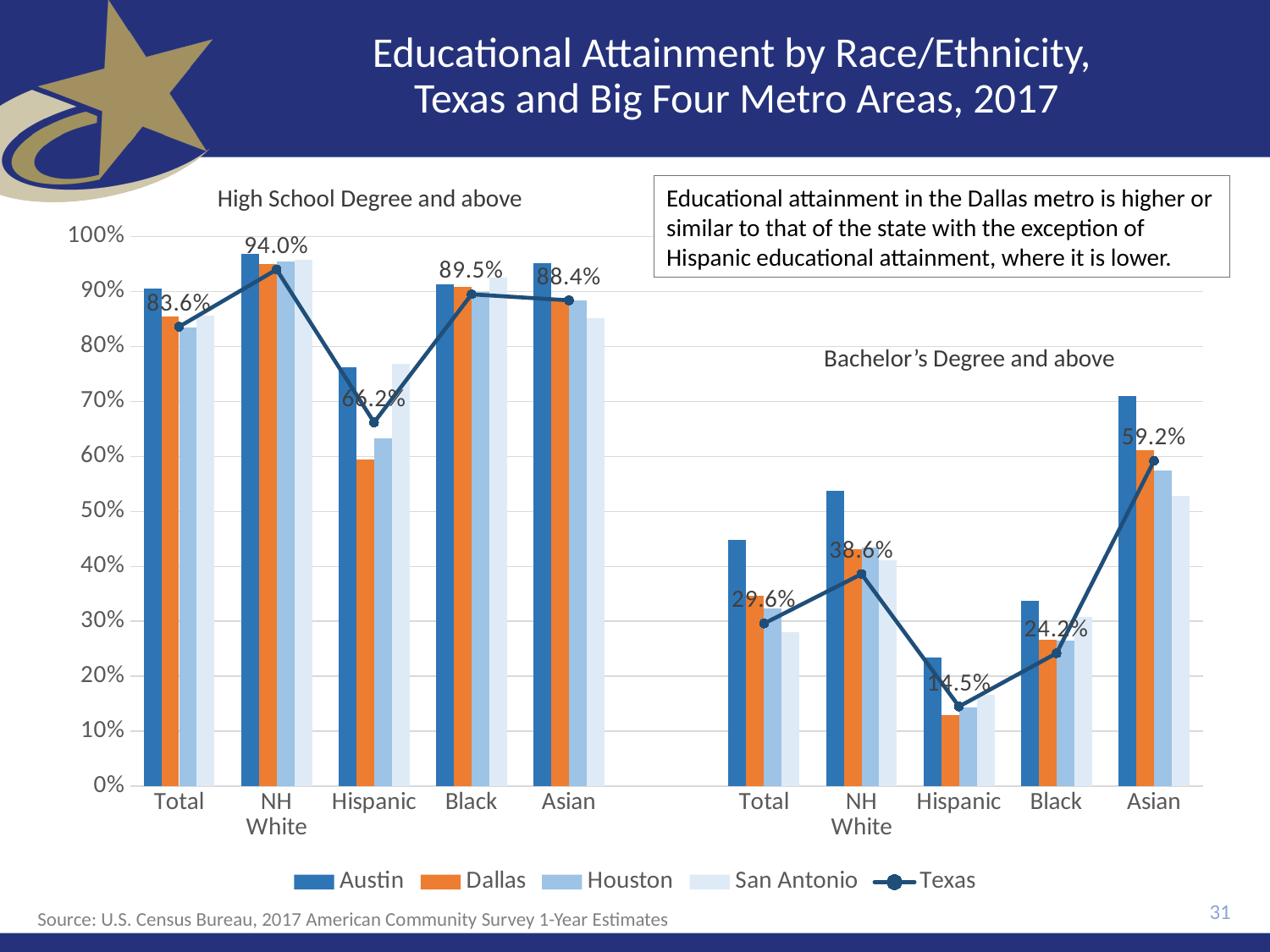
In the Bachelor's Degree and above section, what is the Texas value for Hispanic? 14.5% In the Bachelor's Degree and above section, is the Total value for Austin greater or less than 40%? greater In the High School Degree and above section, which category has the highest Texas value? NH White In the Bachelor's Degree and above section, which category has the lowest Texas value? Hispanic In the High School Degree and above section, what is the difference between the Texas values for NH White and Hispanic? 27.8% In the High School Degree and above section, what is the Texas value for Hispanic? 66.2% In the Bachelor's Degree and above section, what is the Texas value for Asian? 59.2% In the High School Degree and above section, what is the Texas value for NH White? 94.0% In the High School Degree and above section, is the Hispanic value for Austin or Dallas larger? Austin In the Bachelor's Degree and above section, what is the difference between the Texas values for Asian and Total? 29.6% How many series does the legend list? 5 How many race/ethnicity categories are shown in the Bachelor's Degree and above section? 5